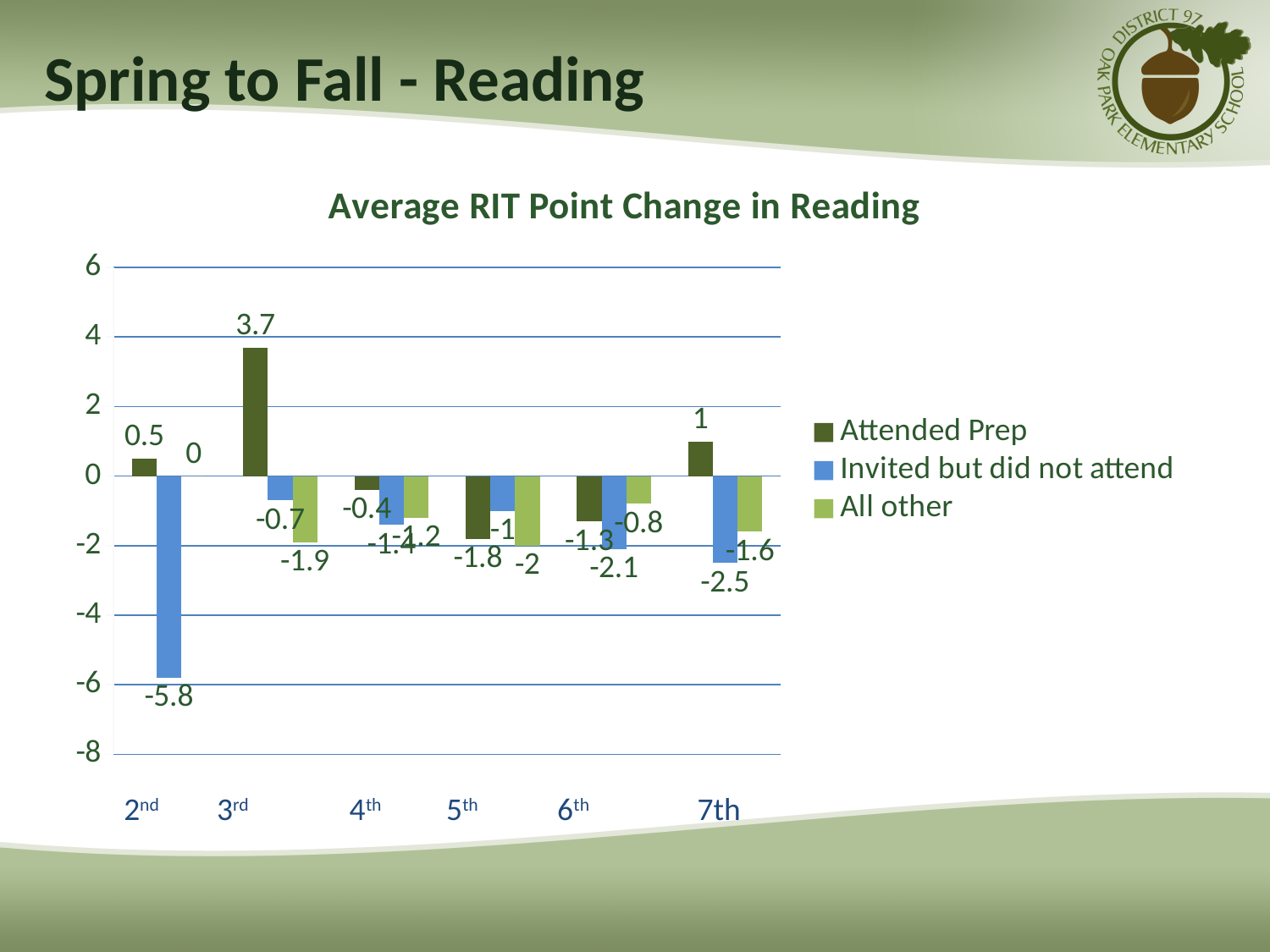
What is the value for All other in 5th grade? -2 Which grade has the highest value for Attended Prep? 3rd What is the difference between the Attended Prep value and the Invited but did not attend value in 7th grade? 3.5 What is the title of the chart? Average RIT Point Change in Reading What type of chart is shown on the slide? bar chart Which grade has the lowest value for Invited but did not attend? 2nd How many grade-level categories are shown on the x axis? 6 How many series does the legend list? 3 What is the value for Invited but did not attend in 2nd grade? -5.8 What is the value for Attended Prep in 3rd grade? 3.7 In 6th grade, which is larger: the value for Attended Prep or the value for Invited but did not attend? Attended Prep What is the value for Attended Prep in 7th grade? 1